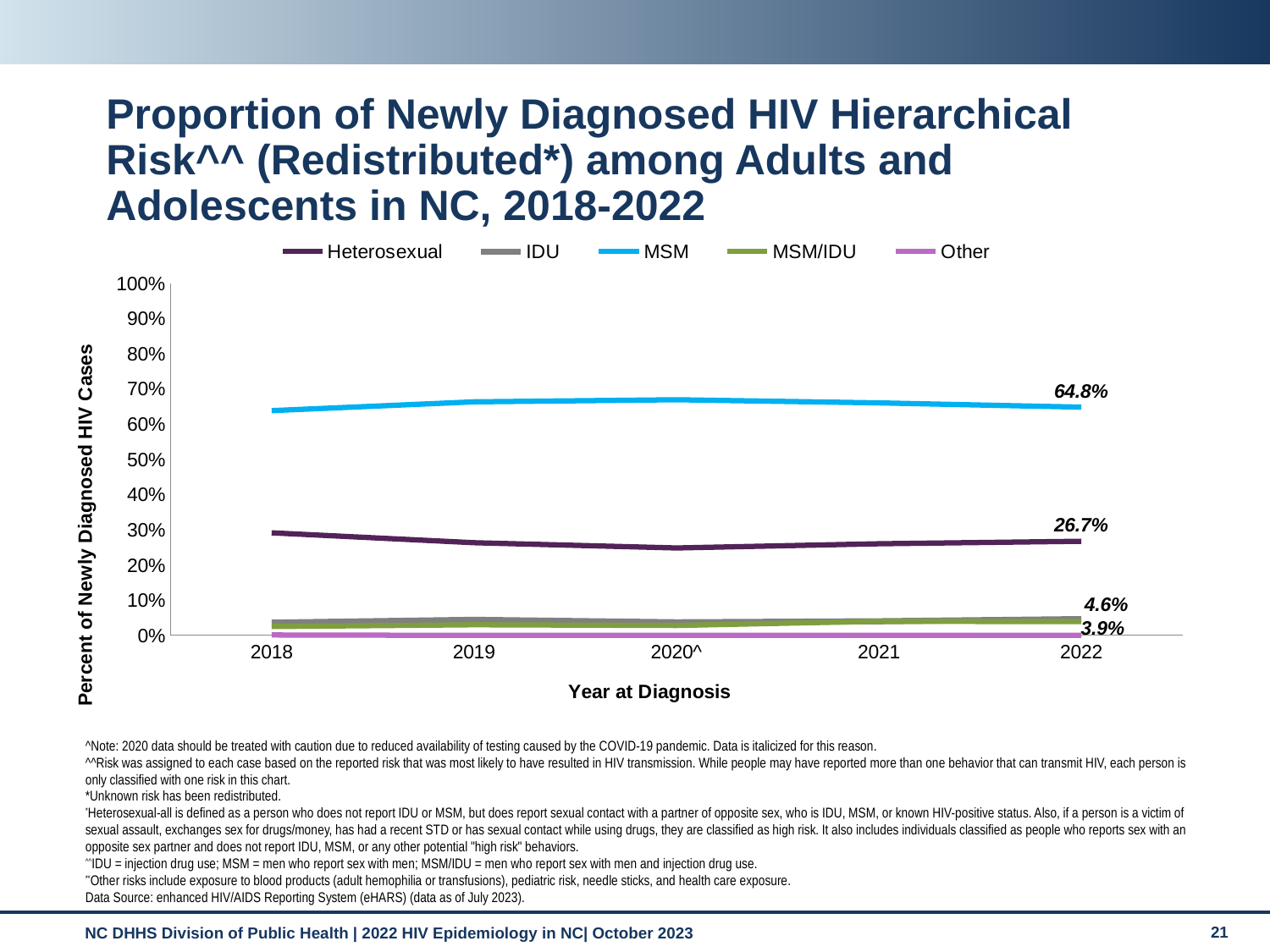
Is the value for MSM in 2018 greater or less than 60%? greater Which risk category has the highest proportion in 2022? MSM How many series does the legend list? 5 How many years are shown on the x axis? 5 Which risk category has the lowest proportion across the years shown? Other What is the difference between the MSM and Heterosexual values in 2022? 38.1 percentage points What is the value for Heterosexual in 2022? 26.7% What is the value for MSM in 2022? 64.8% What kind of chart is shown on the slide? Line chart Does the Heterosexual line rise or fall from 2018 to 2020^? fall Is the value for Heterosexual in 2020^ greater or less than 30%? less What is the title of the x axis? Year at Diagnosis